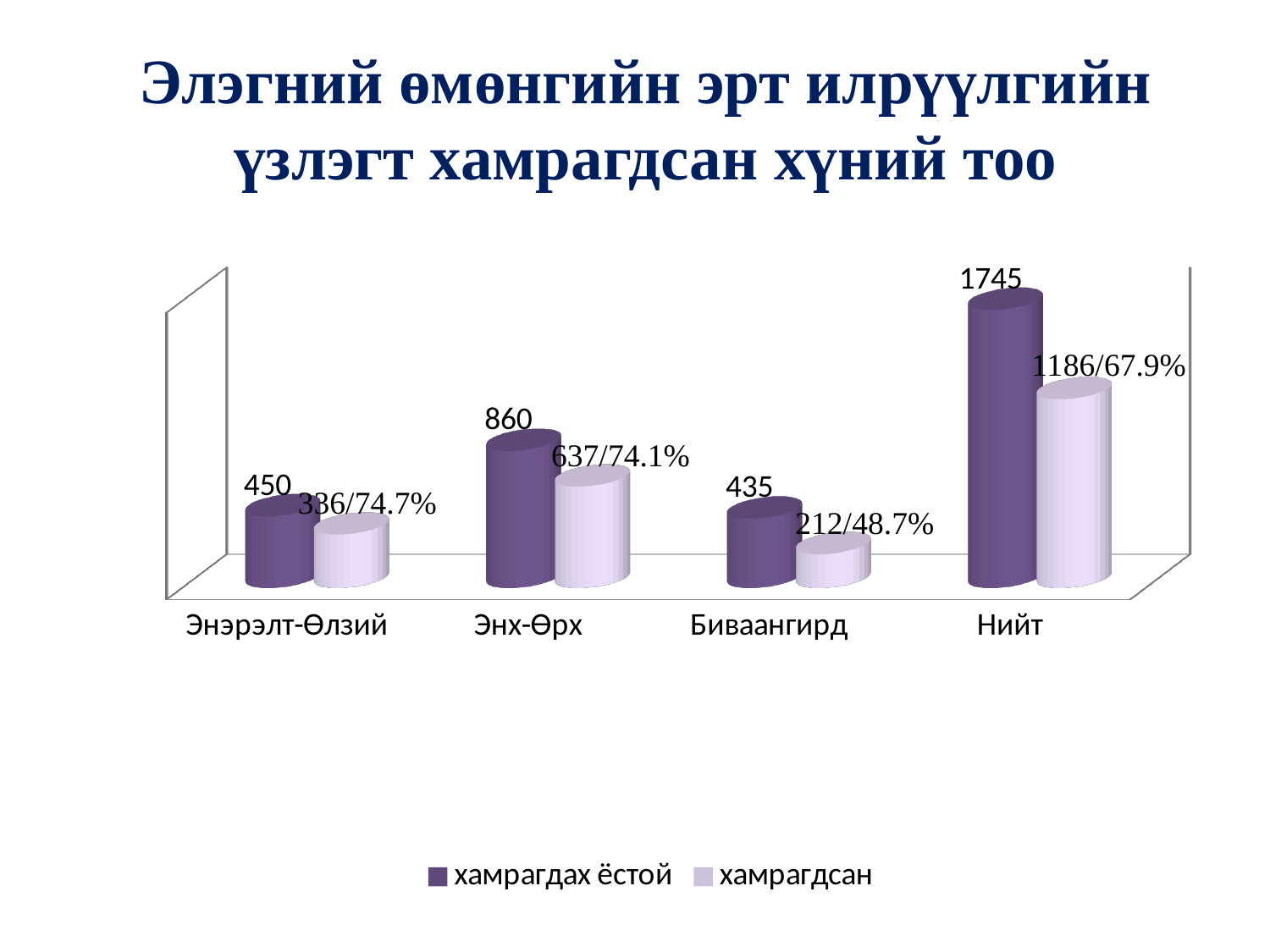
What is the difference between хамрагдах ёстой and хамрагдсан for Нийт? 559 What kind of chart is shown on the slide? Bar chart Which category has the lowest хамрагдах ёстой value? Биваангирд Which category has the highest хамрагдах ёстой value? Нийт How many categories are shown on the x axis? 4 How many series does the legend list? 2 What is the value of хамрагдах ёстой for Энх-Өрх? 860 What is the value of хамрагдах ёстой for Биваангирд? 435 What data label is shown for хамрагдсан at Нийт? 1186/67.9% Which is larger, хамрагдах ёстой for Энэрэлт-Өлзий or for Энх-Өрх? Энх-Өрх What is the value of хамрагдах ёстой for Нийт? 1745 What data label is shown for хамрагдсан at Биваангирд? 212/48.7%